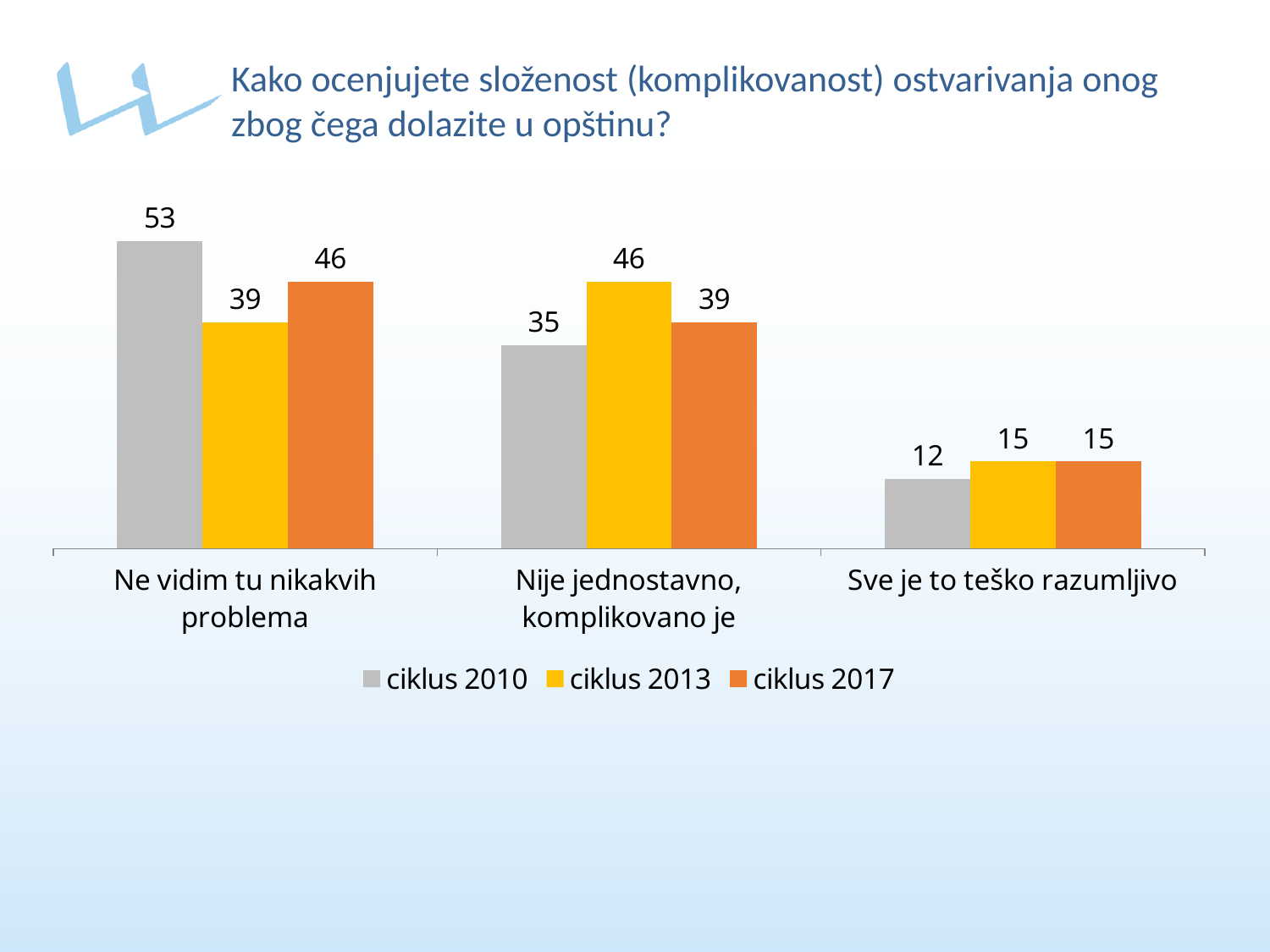
What is the value for "Nije jednostavno, komplikovano je" in the ciklus 2013 series? 46 What is the value for "Ne vidim tu nikakvih problema" in the ciklus 2010 series? 53 Which category has the lowest value in the ciklus 2013 series? Sve je to teško razumljivo How many series does the legend list? 3 What kind of chart is shown on the slide? bar chart What is the difference between the ciklus 2010 and ciklus 2017 values for "Ne vidim tu nikakvih problema"? 7 How many categories are shown on the x axis? 3 Which colour represents the ciklus 2013 series? yellow Which category has the highest value in the ciklus 2010 series? Ne vidim tu nikakvih problema What is the value for "Sve je to teško razumljivo" in the ciklus 2017 series? 15 What is the value for "Ne vidim tu nikakvih problema" in the ciklus 2017 series? 46 Which is larger for "Nije jednostavno, komplikovano je": the ciklus 2010 value or the ciklus 2013 value? ciklus 2013